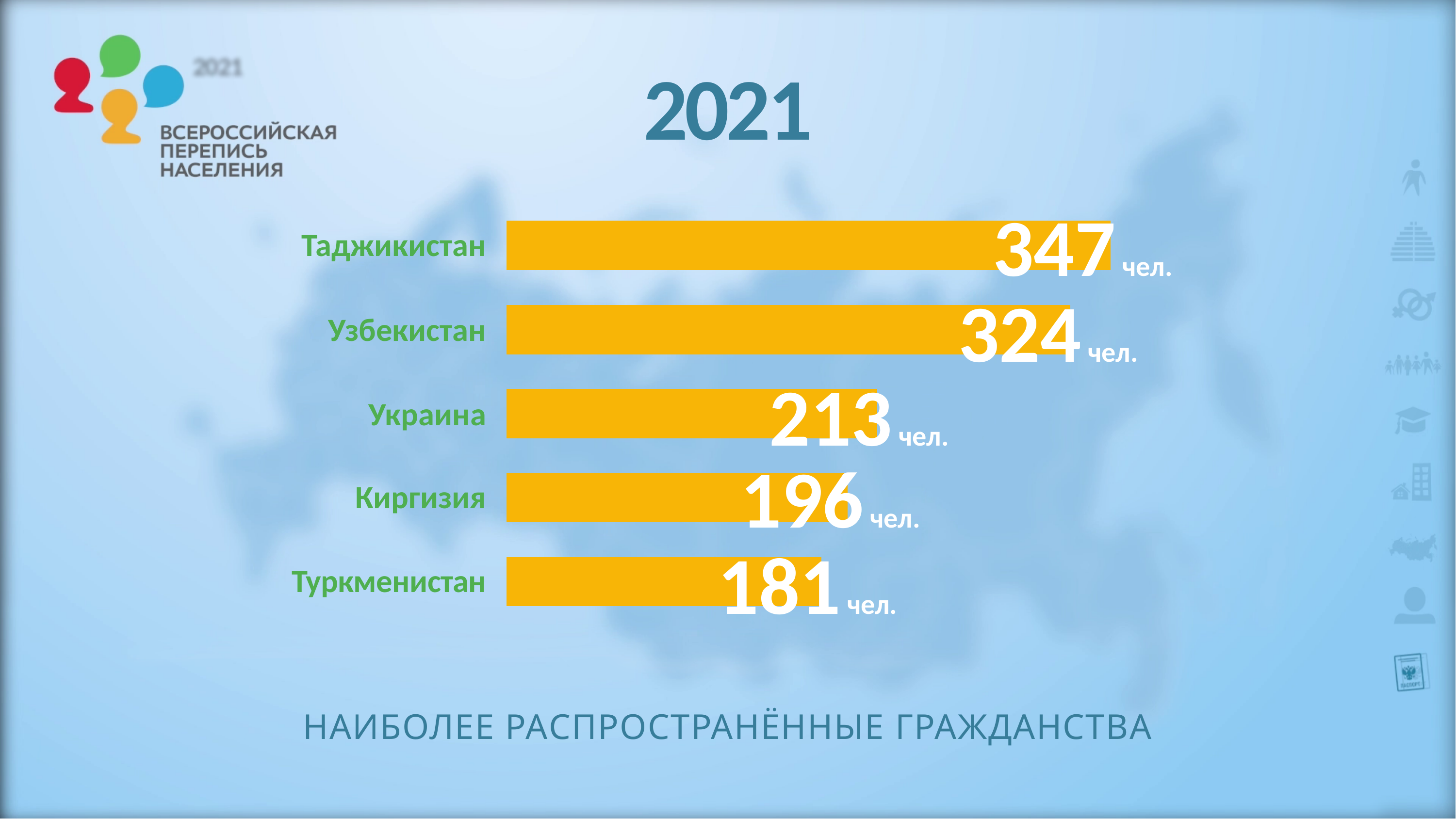
What is the value for Украина? 213 чел. What kind of chart is shown on the slide? Bar chart What is the value for Киргизия? 196 чел. Which category has the lowest value? Туркменистан What is the value for Таджикистан? 347 чел. How many categories are shown in the chart? 5 Which category has the highest value? Таджикистан What is the difference between the values for Таджикистан and Узбекистан? 23 чел. Which is larger, the value for Украина or the value for Киргизия? Украина What is the value for Узбекистан? 324 чел. What is the value for Туркменистан? 181 чел. What is the difference between the values for Украина and Туркменистан? 32 чел.